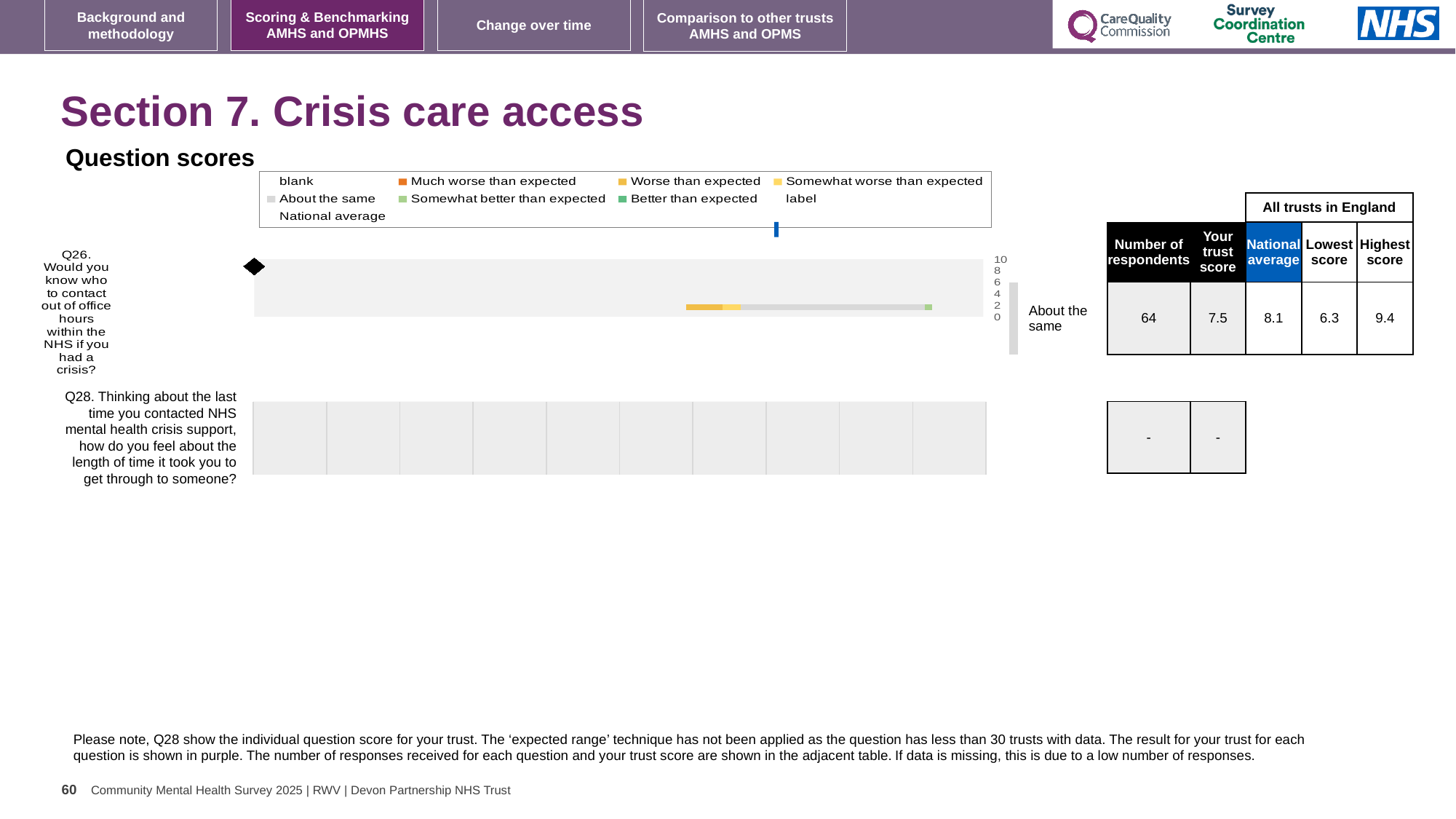
Which is larger for Q26, the trust score or the national average? National average Is the trust score for Q26 greater or less than 8? less What is the trust score for Q26 (Would you know who to contact out of office hours within the NHS if you had a crisis?)? 7.5 What is the highest score among all trusts in England for Q26? 9.4 What is the national average score for Q26? 8.1 What is the difference between the highest and lowest scores for Q26 across all trusts in England? 3.1 What kind of chart is used to show the question scores? Bar chart How many respondents answered Q26? 64 What is the lowest score among all trusts in England for Q26? 6.3 What benchmark category is shown for Q26? About the same What is the maximum value shown on the score axis of the chart? 10 What is the difference between the national average and the trust score for Q26? 0.6